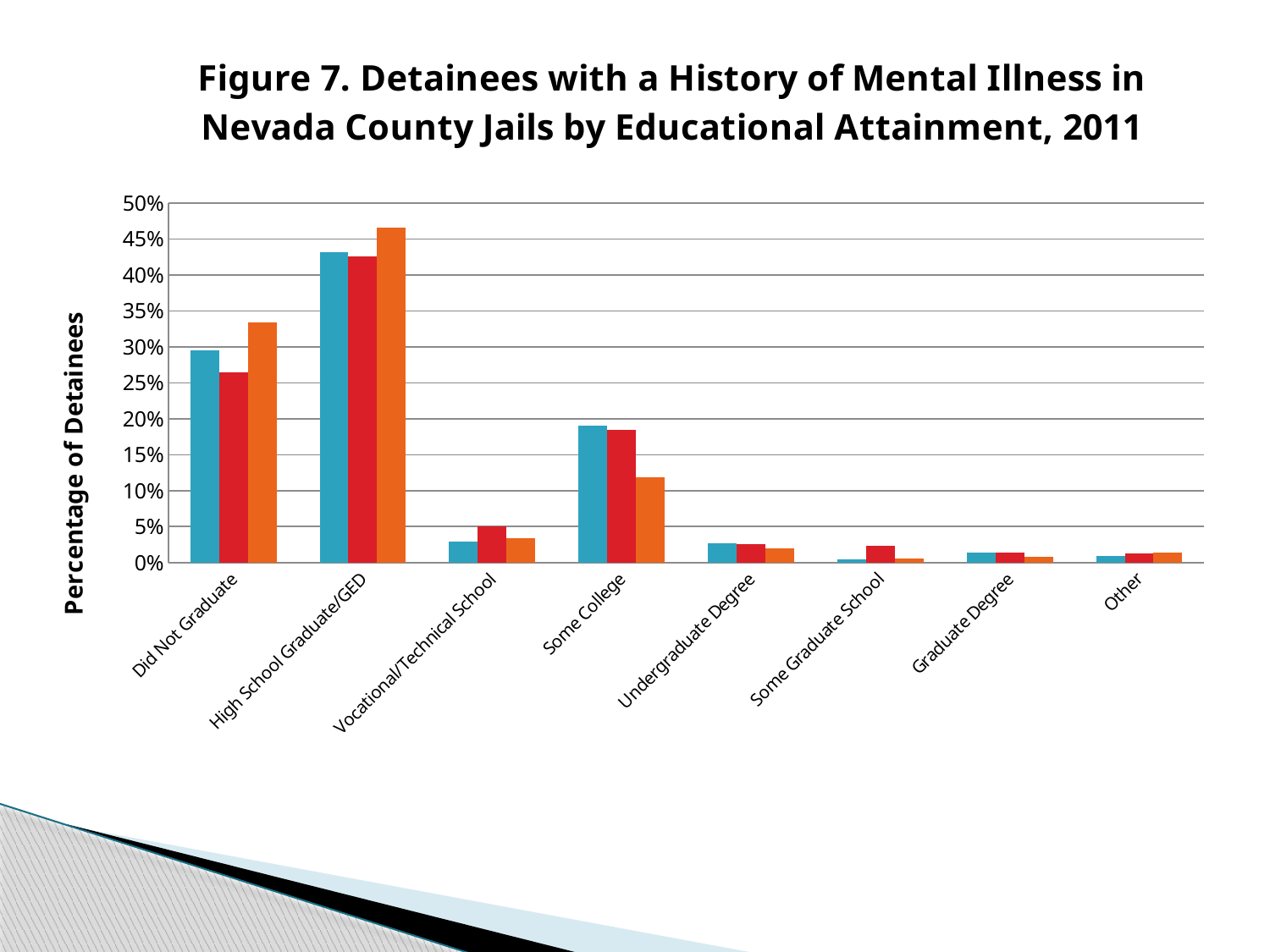
For Some College, which is larger: the red bar or the orange bar? the red bar Is the orange bar for High School Graduate/GED greater or less than 40%? greater What kind of chart is shown on the slide? bar chart How many educational attainment categories are shown on the x axis? 8 How many bars are plotted for each educational attainment category? 3 Is the blue bar for Did Not Graduate greater or less than 25%? greater For Did Not Graduate, which is larger: the blue bar or the red bar? the blue bar What is the label on the vertical axis of the chart? Percentage of Detainees Is the orange bar for Some College greater or less than 15%? less Which educational attainment category has the tallest bars? High School Graduate/GED